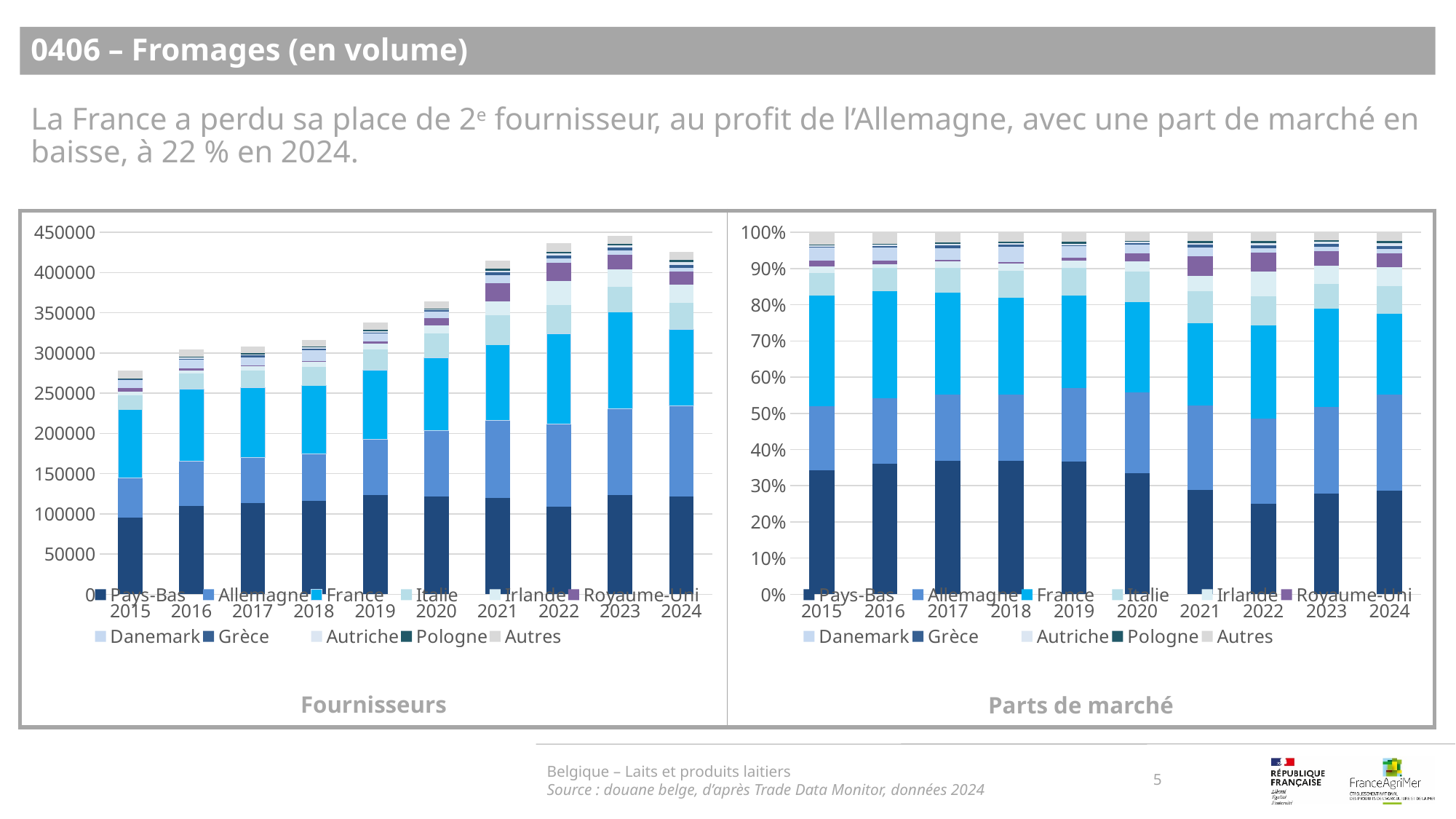
How many years are shown on the x axis of the 'Parts de marché' chart? 10 In the 'Parts de marché' chart, is the Pays-Bas share in 2017 larger or smaller than in 2024? larger In the 'Parts de marché' chart, does the Pays-Bas share rise or fall from 2019 to 2024? fall In the 'Fournisseurs' chart, is the total bar for 2023 greater or less than 400000? greater How many series does the legend of the 'Fournisseurs' chart list? 11 In the 'Fournisseurs' chart, which year has the highest total bar? 2023 In the 'Parts de marché' chart, is the Pays-Bas share in 2024 greater or less than 30%? less What is the title of the chart on the right of the slide? Parts de marché In the 'Fournisseurs' chart, do the total bars generally rise or fall from 2015 to 2023? rise What kind of chart is the 'Fournisseurs' chart on the left? Stacked bar chart In the 'Fournisseurs' chart, is the total bar for 2015 greater or less than 300000? less In the 'Fournisseurs' chart, which year has the lowest total bar? 2015